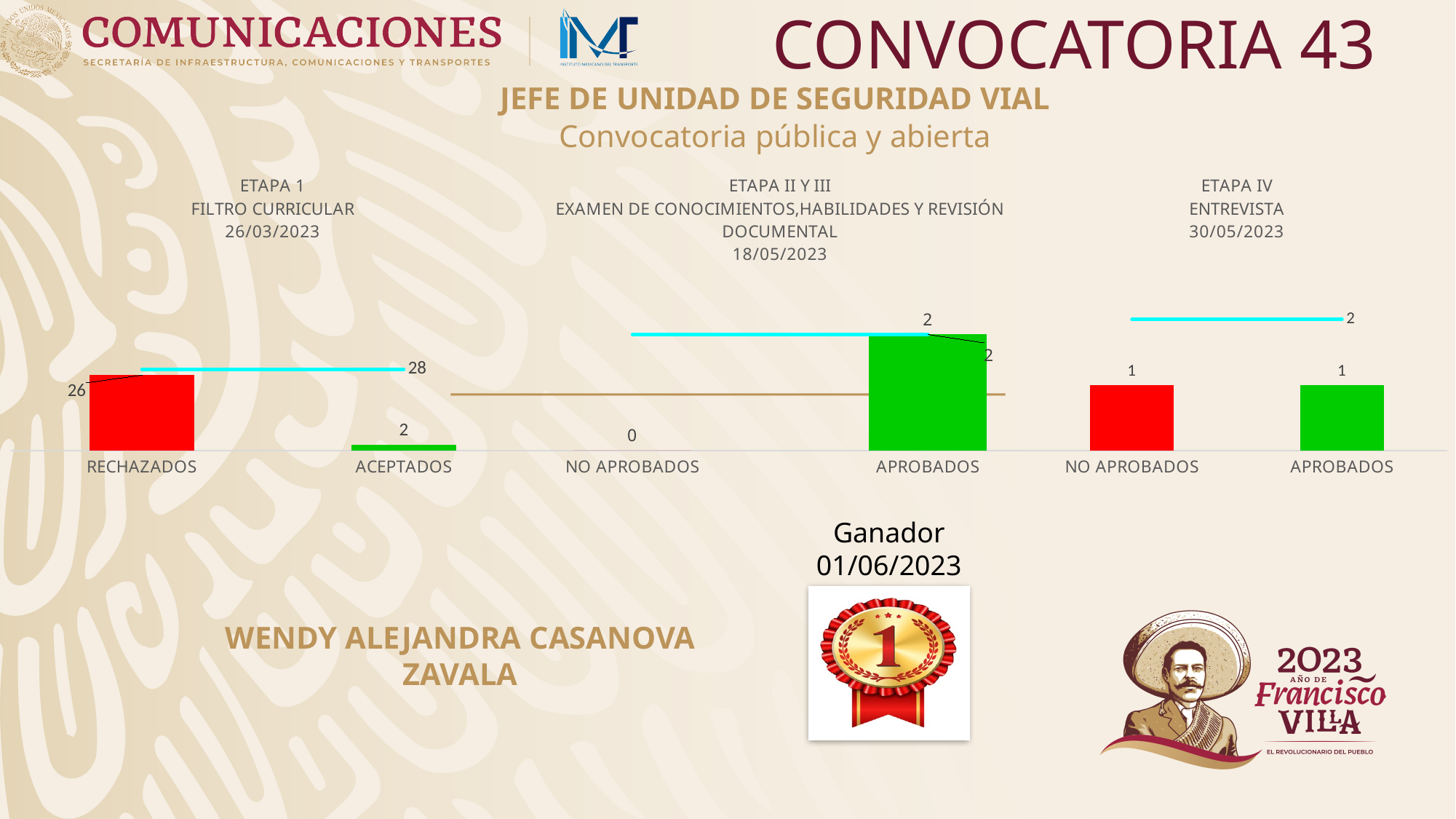
Which category has the highest bar in the chart? RECHAZADOS What is the value of the NO APROBADOS bar under Etapa II y III? 0 What is the value of the NO APROBADOS bar under Etapa IV (Entrevista)? 1 Which is larger, the RECHAZADOS bar or the ACEPTADOS bar in Etapa 1? RECHAZADOS What is the value of the RECHAZADOS bar in Etapa 1? 26 Which category has the lowest bar in the chart? NO APROBADOS (Etapa II y III) What is the value of the ACEPTADOS bar in Etapa 1? 2 What is the difference between the RECHAZADOS and ACEPTADOS bars in Etapa 1? 24 What is the value of the APROBADOS bar under Etapa II y III? 2 How many bar categories are shown along the x axis of the chart? 6 What value is labelled on the cyan line above the Etapa 1 bars? 28 What kind of chart is shown on the slide? Combination bar and line chart